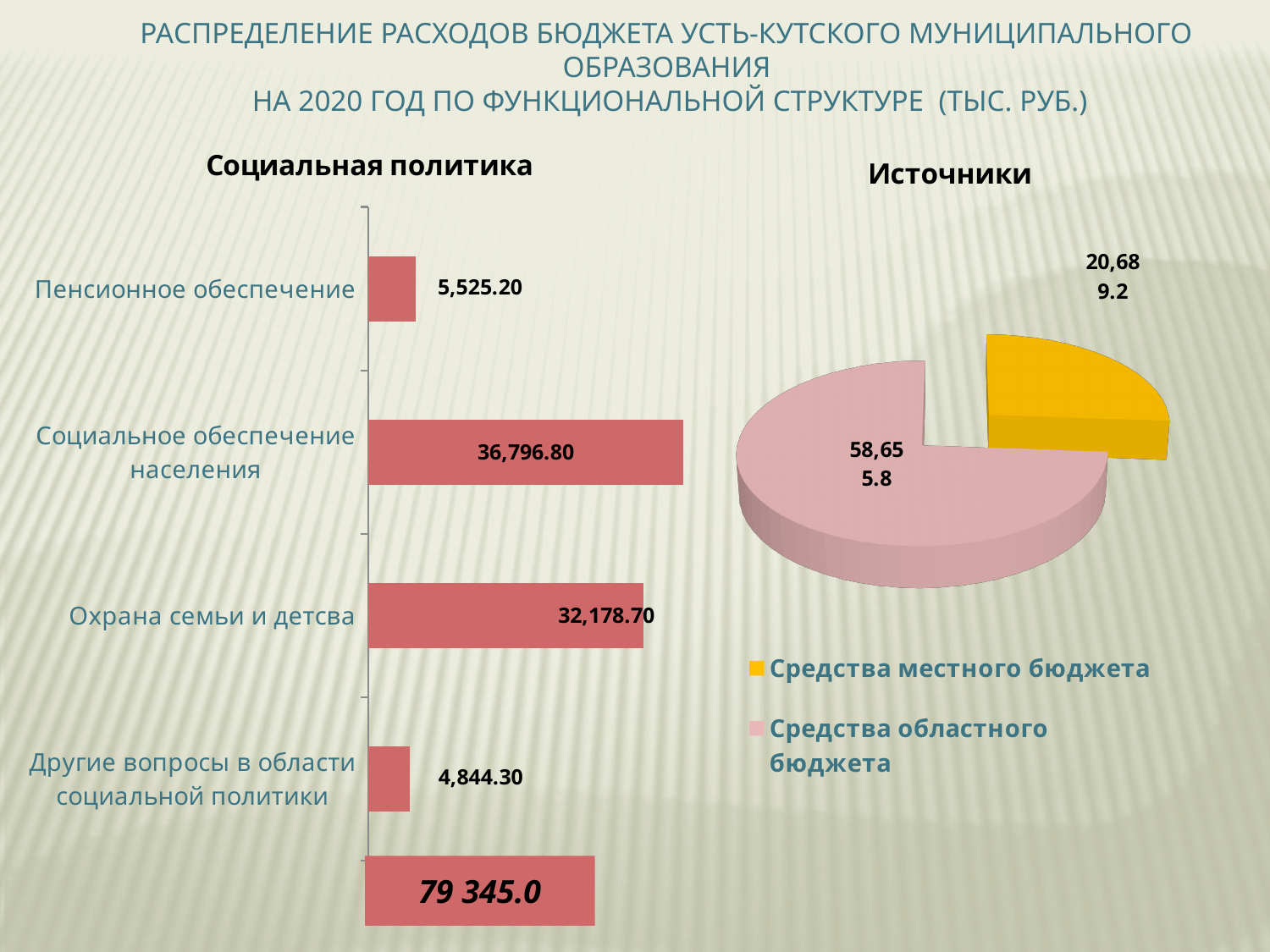
In the 'Социальная политика' chart, which category has the lowest value? Другие вопросы в области социальной политики In the 'Социальная политика' chart, what is the value for 'Охрана семьи и детсва'? 32,178.70 In the 'Социальная политика' chart, what is the value for 'Другие вопросы в области социальной политики'? 4,844.30 In the 'Социальная политика' chart, which category has the highest value? Социальное обеспечение населения In the 'Источники' chart, which source has the larger share: 'Средства местного бюджета' or 'Средства областного бюджета'? Средства областного бюджета What kind of chart is the 'Социальная политика' chart? bar chart In the 'Социальная политика' chart, which is larger: 'Пенсионное обеспечение' or 'Другие вопросы в области социальной политики'? Пенсионное обеспечение In the 'Социальная политика' chart, what is the difference between 'Социальное обеспечение населения' and 'Охрана семьи и детсва'? 4,618.10 In the 'Социальная политика' chart, what is the value for 'Пенсионное обеспечение'? 5,525.20 How many entries does the legend of the 'Источники' chart list? 2 How many categories are shown in the 'Социальная политика' chart? 4 In the 'Социальная политика' chart, what is the value for 'Социальное обеспечение населения'? 36,796.80